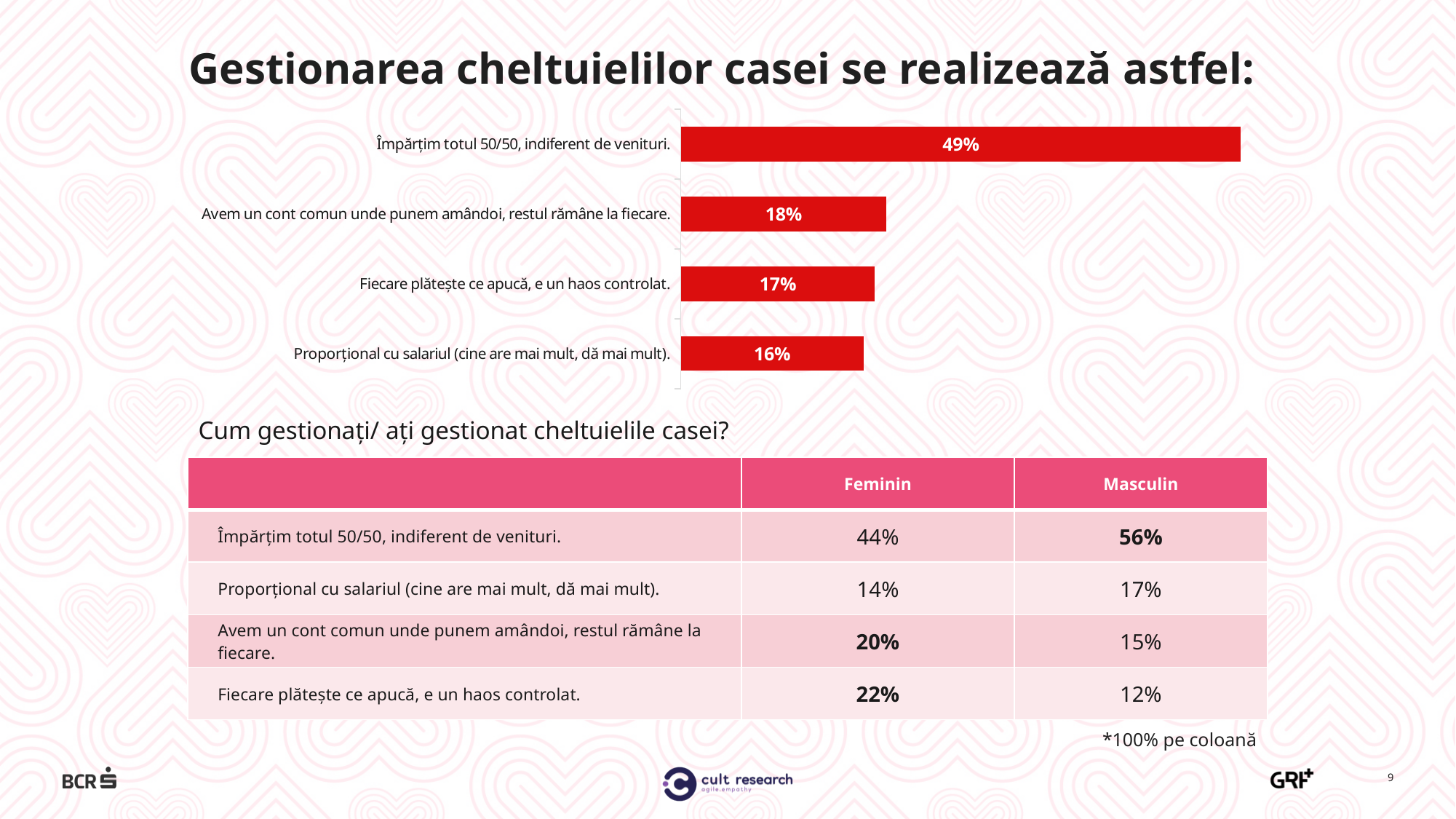
What is the difference between the value for "Împărțim totul 50/50, indiferent de venituri." and the value for "Avem un cont comun unde punem amândoi, restul rămâne la fiecare."? 31% What percentage of respondents said they split everything 50/50 regardless of income ("Împărțim totul 50/50, indiferent de venituri.")? 49% What is the value shown for "Avem un cont comun unde punem amândoi, restul rămâne la fiecare."? 18% Which category has the highest value in the bar chart? Împărțim totul 50/50, indiferent de venituri. What colour are the bars in the chart? Red What is the value shown for "Proporțional cu salariul (cine are mai mult, dă mai mult)."? 16% Which is larger: the value for "Avem un cont comun unde punem amândoi, restul rămâne la fiecare." or the value for "Proporțional cu salariul (cine are mai mult, dă mai mult)."? Avem un cont comun unde punem amândoi, restul rămâne la fiecare. What is the difference between the value for "Fiecare plătește ce apucă, e un haos controlat." and the value for "Proporțional cu salariul (cine are mai mult, dă mai mult)."? 1% What type of chart is shown on the slide? Bar chart How many categories are shown in the bar chart? 4 Which category has the lowest value in the bar chart? Proporțional cu salariul (cine are mai mult, dă mai mult). What is the value shown for "Fiecare plătește ce apucă, e un haos controlat."? 17%